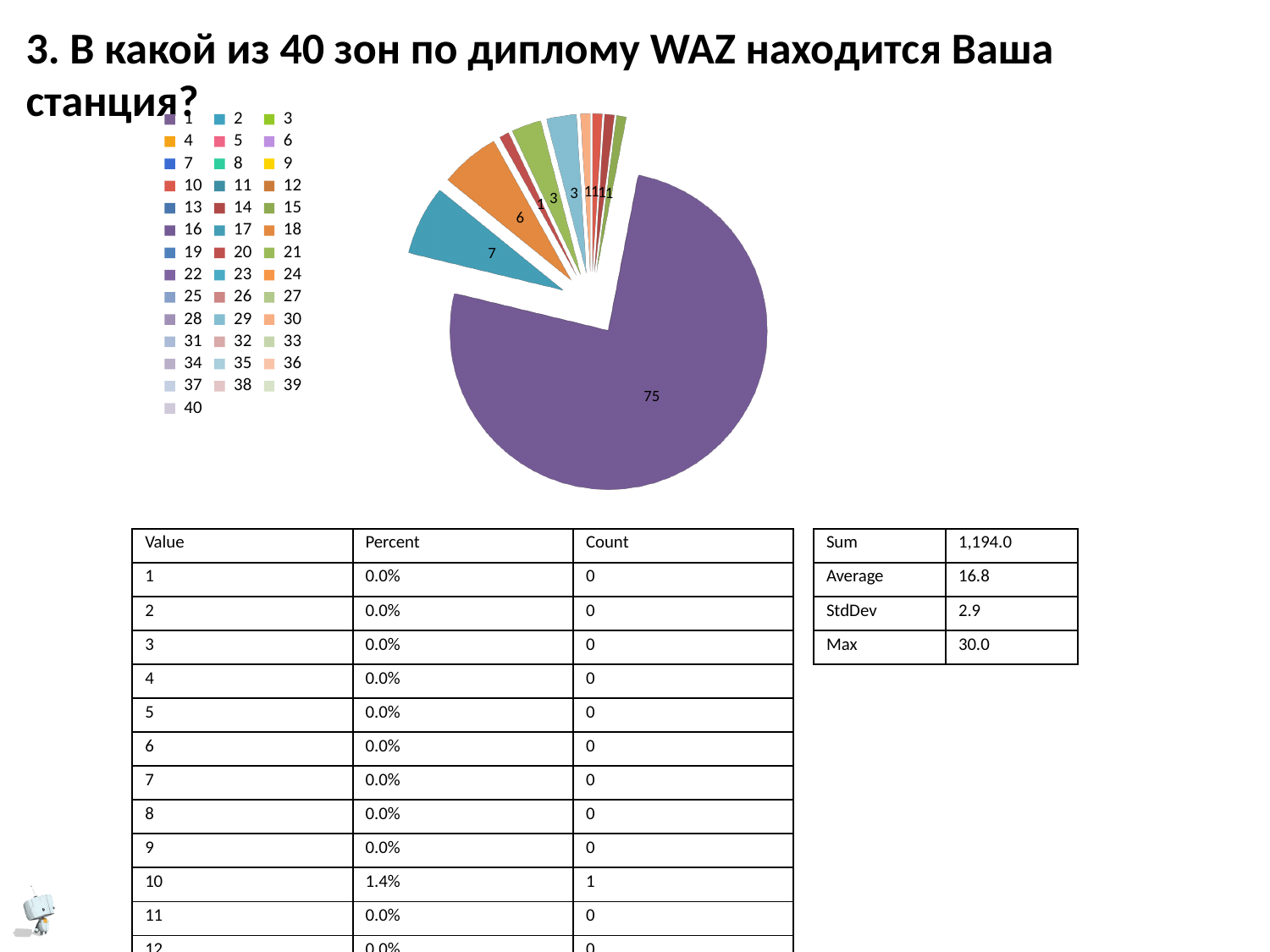
What is the value of the largest slice in the pie chart? 75 How many entries does the legend of the pie chart list? 40 What is the smallest data label value shown on the pie chart? 1 What is the value of the second-largest slice in the pie chart? 7 What colour is the largest slice of the pie chart? purple Which is larger in the pie chart: the slice labelled 7 or the slice labelled 6? 7 What kind of chart is shown on the slide? pie chart What is the title of the slide containing the pie chart? 3. В какой из 40 зон по диплому WAZ находится Ваша станция? What is the difference between the largest slice (75) and the second-largest slice (7) in the pie chart? 68 Is the value of the largest slice in the pie chart greater or less than 50? greater